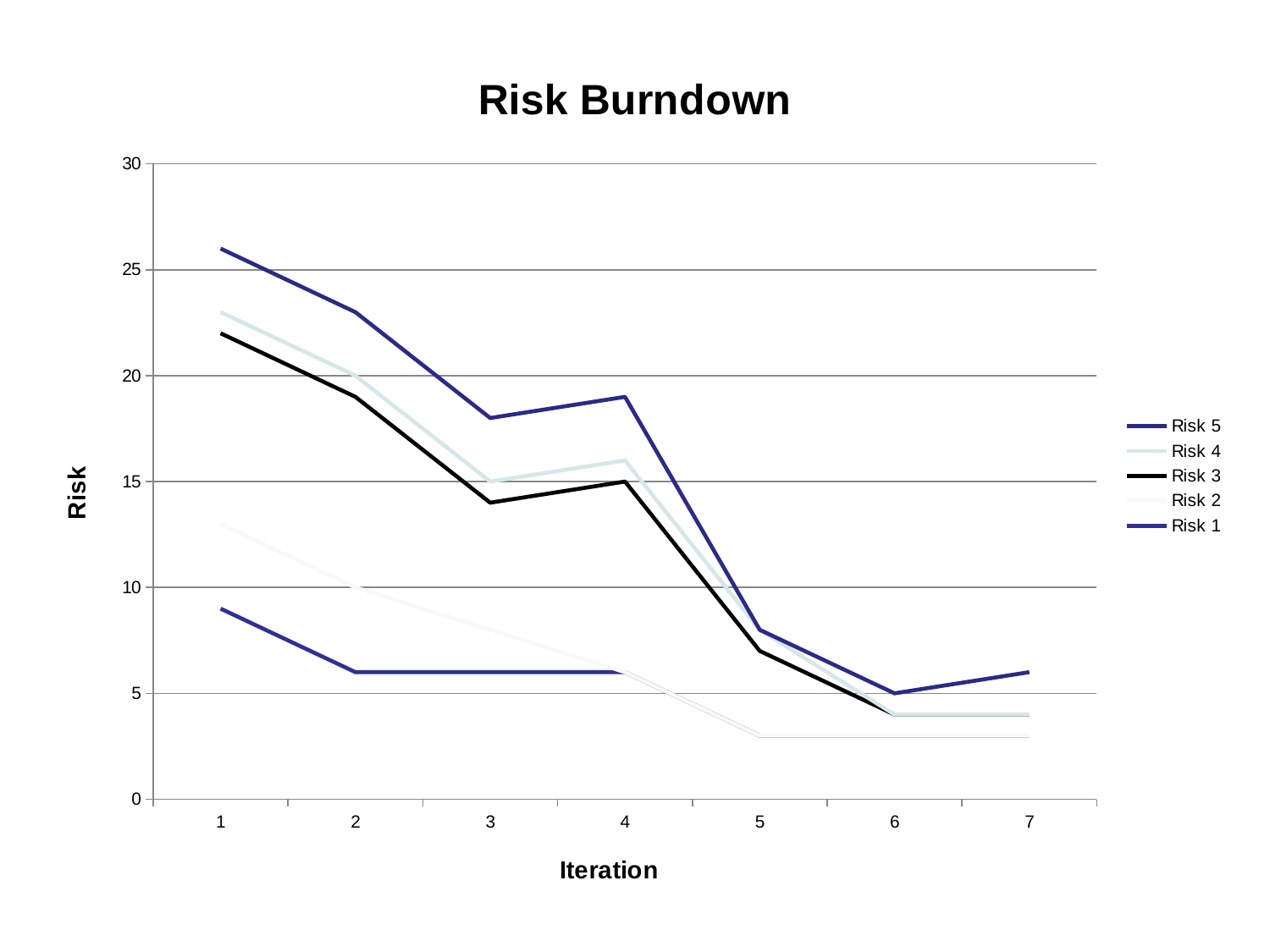
What is the title of the chart? Risk Burndown What kind of chart is shown on the slide? line chart What is the value of Risk 4 at iteration 2? 20 Is the value of Risk 3 at iteration 5 greater or less than 10? less What is the value of Risk 3 at iteration 4? 15 Does the Risk 3 line generally rise or fall from iteration 1 to iteration 7? fall What is the label of the x axis? Iteration Is the value of Risk 3 at iteration 1 greater or less than 20? greater How many iterations are plotted along the x axis? 7 How many series does the legend list? 5 What is the value of Risk 4 at iteration 3? 15 By how much does Risk 4 drop between iteration 2 and iteration 3? 5